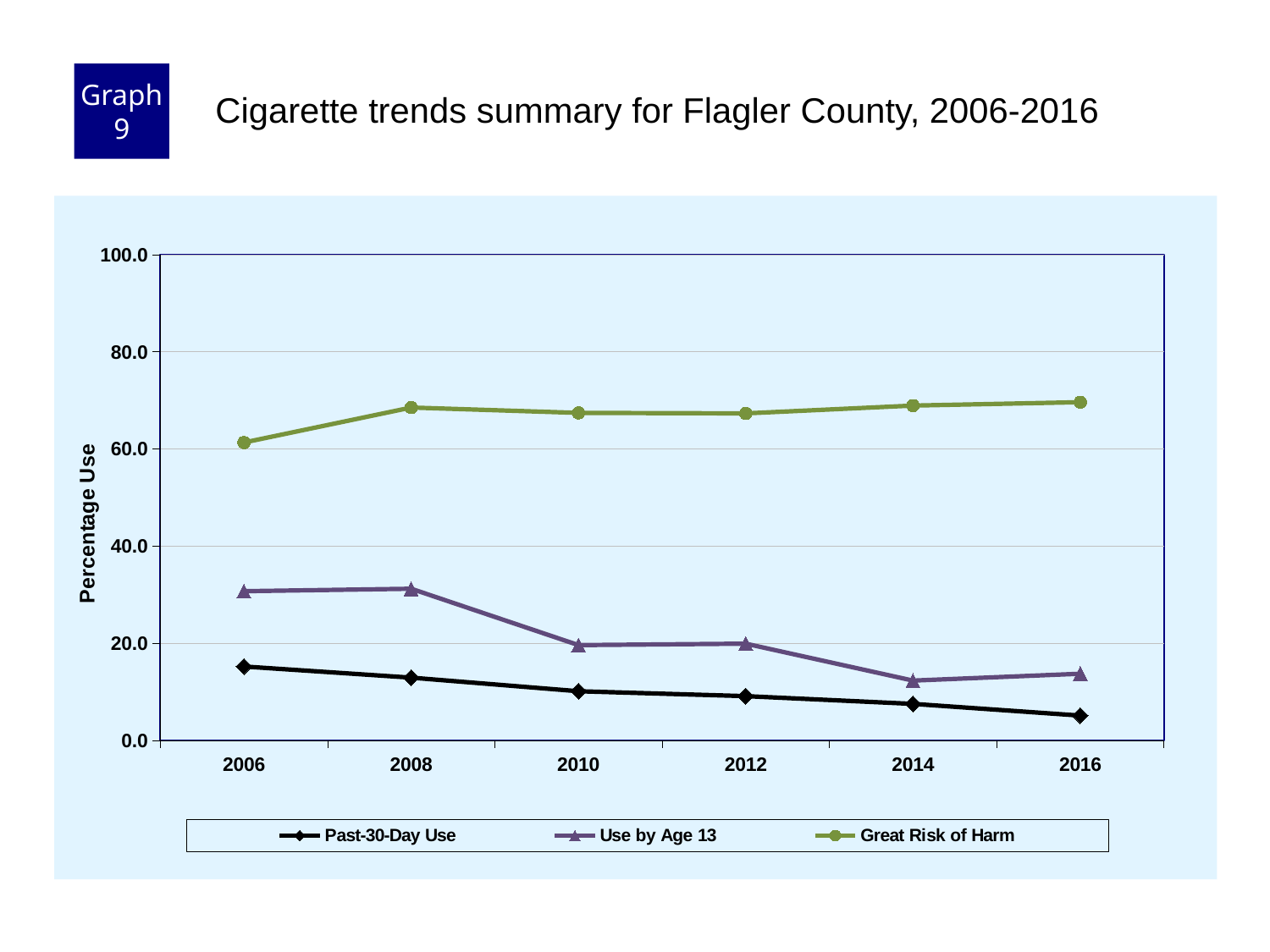
In which year is Past-30-Day Use at its highest? 2006 In which year is Past-30-Day Use at its lowest? 2016 Is the value for Use by Age 13 in 2014 greater or less than 20.0? less In which year is Great Risk of Harm at its lowest? 2006 What kind of chart is shown on the slide? line chart Which series is plotted highest on the chart across all years? Great Risk of Harm Is the value for Use by Age 13 in 2006 greater or less than 20.0? greater Does Past-30-Day Use rise or fall from 2006 to 2016? fall How many years are plotted along the x axis? 6 Is the value for Great Risk of Harm in 2008 greater or less than 80.0? less How many series does the legend list? 3 What is the title of the chart? Cigarette trends summary for Flagler County, 2006-2016